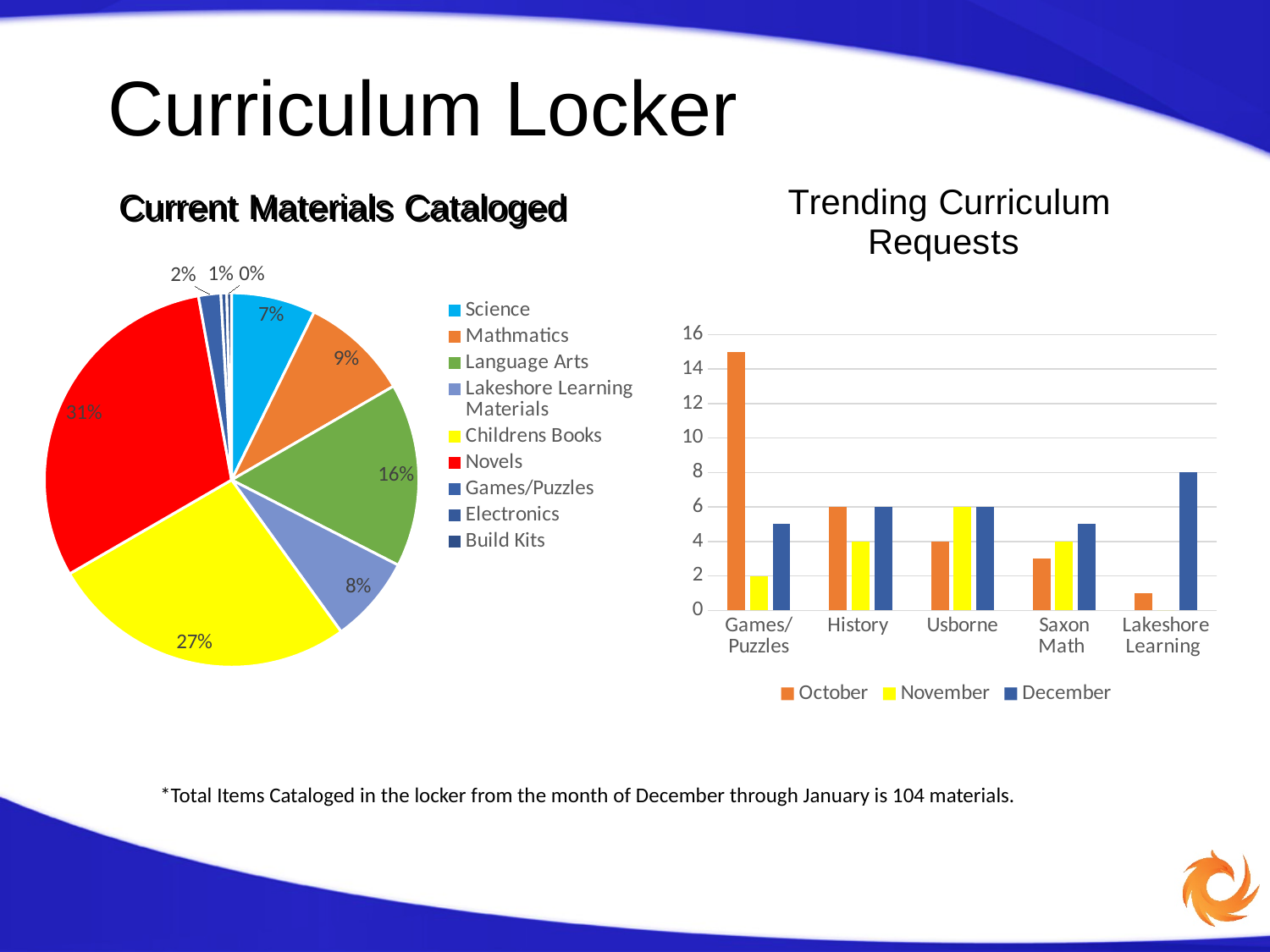
How many series does the legend of the Trending Curriculum Requests chart list? 3 In the Trending Curriculum Requests chart, which month has the highest value for Lakeshore Learning? December How many categories does the legend of the Current Materials Cataloged pie chart list? 9 In the Current Materials Cataloged pie chart, what percentage is Language Arts? 16% In the Current Materials Cataloged pie chart, how many percentage points larger is Novels than Childrens Books? 4% In the Current Materials Cataloged pie chart, which category has the largest share? Novels What kind of chart is Trending Curriculum Requests? bar chart In the Trending Curriculum Requests chart, is the October value for Games/Puzzles greater or less than 14? greater In the Current Materials Cataloged pie chart, what percentage is Childrens Books? 27% In the Current Materials Cataloged pie chart, which category has the smallest share? Build Kits In the Current Materials Cataloged pie chart, what percentage is Novels? 31% In the Current Materials Cataloged pie chart, which is larger, Mathmatics or Science? Mathmatics